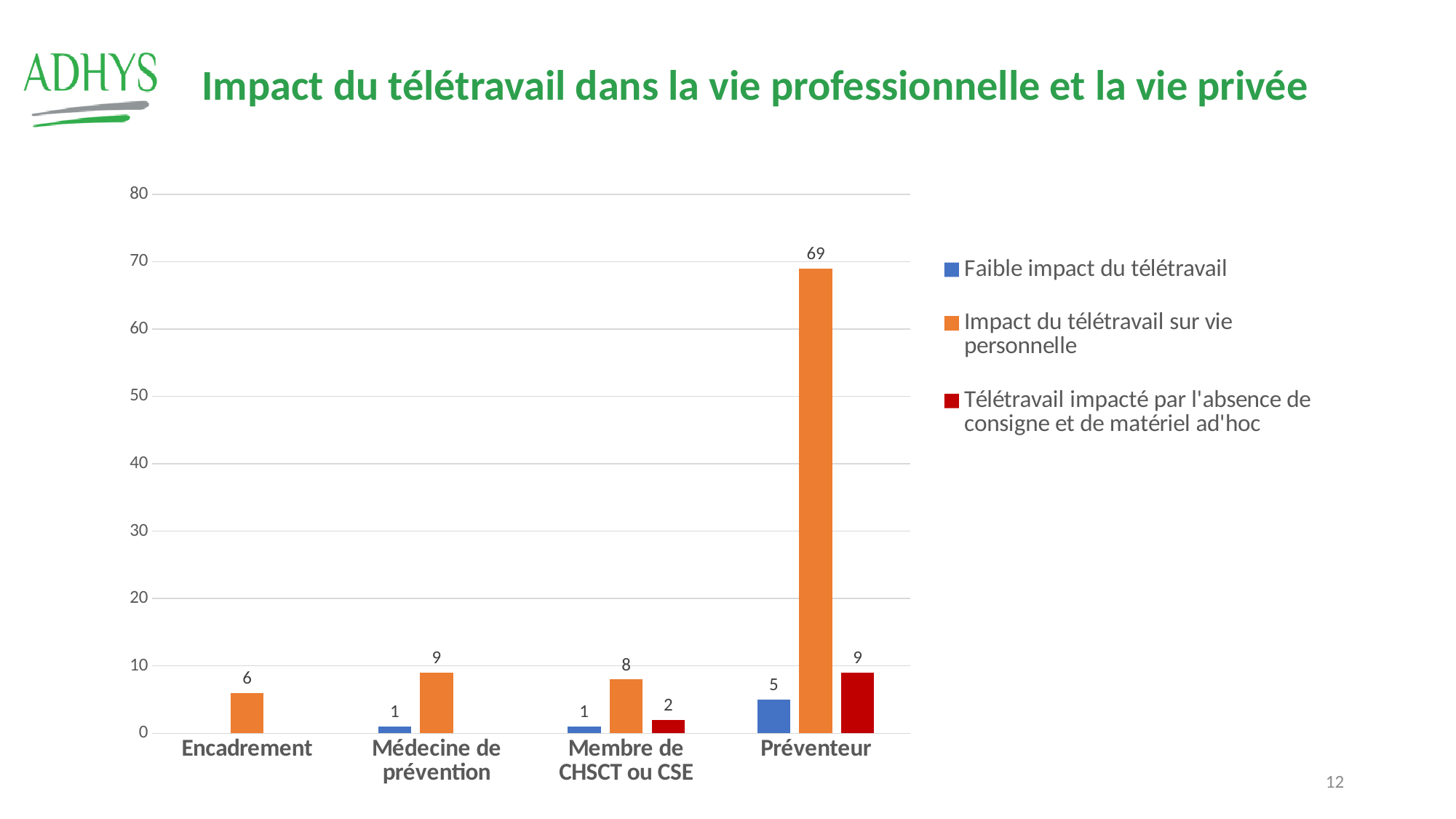
What kind of chart is shown on the slide? Bar chart Which category has the highest value for 'Impact du télétravail sur vie personnelle'? Préventeur What is the value of 'Faible impact du télétravail' for Préventeur? 5 What is the value of 'Impact du télétravail sur vie personnelle' for Encadrement? 6 How many categories are shown on the x axis? 4 How many series does the legend list? 3 What is the value of 'Impact du télétravail sur vie personnelle' for Préventeur? 69 What is the difference between the 'Impact du télétravail sur vie personnelle' values for Préventeur and Médecine de prévention? 60 Which category has the lowest value for 'Impact du télétravail sur vie personnelle'? Encadrement What is the value of 'Télétravail impacté par l'absence de consigne et de matériel ad'hoc' for Membre de CHSCT ou CSE? 2 Is the 'Impact du télétravail sur vie personnelle' value for Préventeur greater or less than 60? greater Which is larger: the 'Impact du télétravail sur vie personnelle' value for Médecine de prévention or for Membre de CHSCT ou CSE? Médecine de prévention